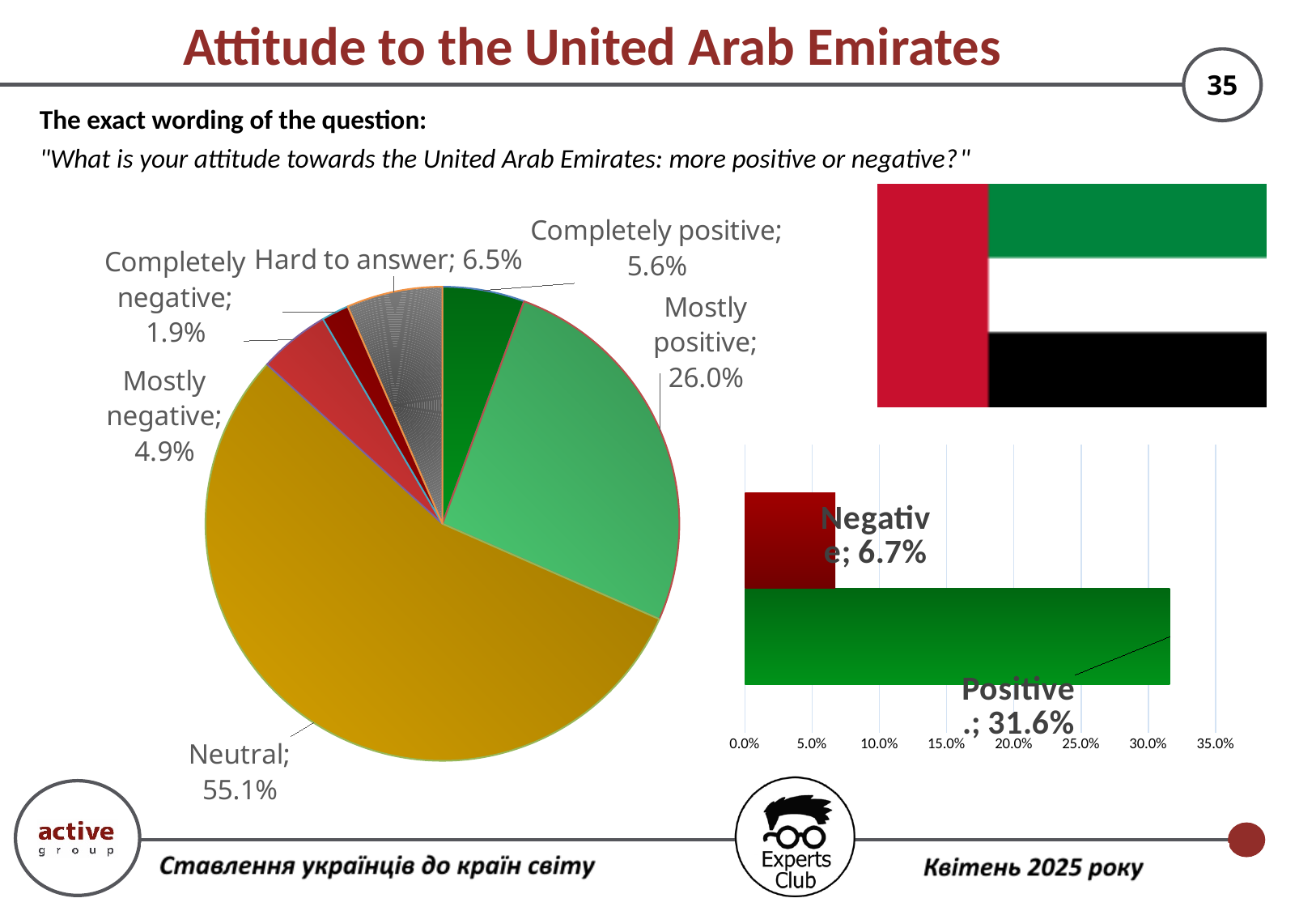
In the pie chart on the left, what share of respondents answered "Neutral"? 55.1% In the pie chart on the left, what is the value for "Hard to answer"? 6.5% In the pie chart on the left, which category has the largest share? Neutral What type of chart is shown on the right side of the slide? Bar chart In the pie chart on the left, how many slices (categories) are shown? 6 In the bar chart on the right, what is the value for "Positive"? 31.6% In the bar chart on the right, what is the value for "Negative"? 6.7% In the pie chart on the left, what is the value for "Mostly positive"? 26.0% In the bar chart on the right, what is the difference between the Positive and Negative values? 24.9 percentage points In the pie chart on the left, which is larger: "Mostly negative" or "Hard to answer"? Hard to answer In the pie chart on the left, which category has the smallest share? Completely negative In the pie chart on the left, what is the difference between "Mostly positive" and "Completely positive"? 20.4 percentage points